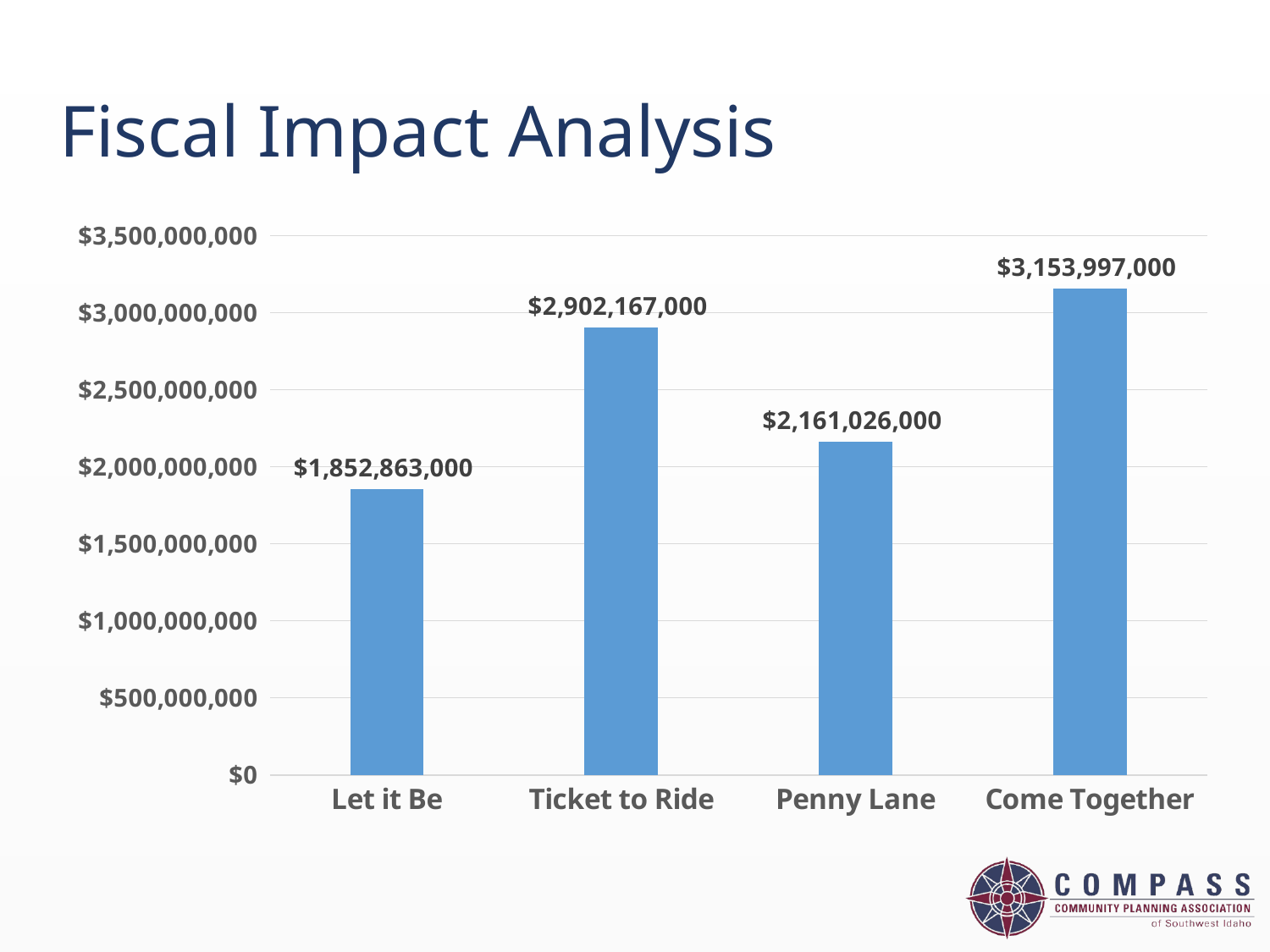
What is the value for Let it Be? $1,852,863,000 Which category has the highest value? Come Together What is the value for Come Together? $3,153,997,000 Which category has the lowest value? Let it Be Is the value for Penny Lane greater or less than $2,000,000,000? greater Which is larger, the value for Ticket to Ride or the value for Penny Lane? Ticket to Ride What is the value for Penny Lane? $2,161,026,000 What is the value for Ticket to Ride? $2,902,167,000 What is the difference between the values for Come Together and Let it Be? $1,301,134,000 What is the difference between the values for Ticket to Ride and Penny Lane? $741,141,000 How many categories are shown on the chart? 4 What kind of chart is shown on the slide? bar chart